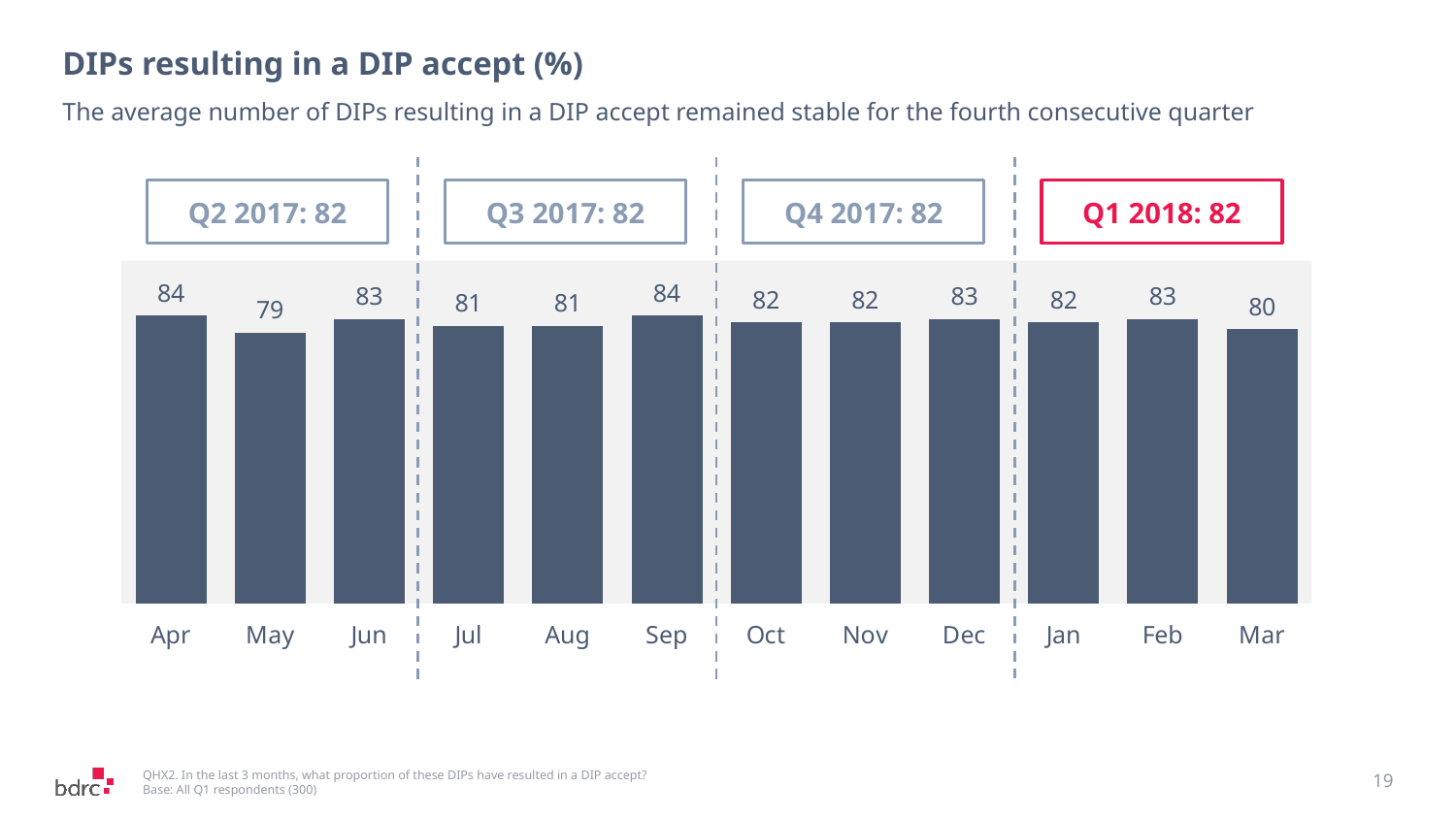
What is the value for Feb? 83 What is the difference between the values for Feb and Mar? 3 What is the title of the chart? DIPs resulting in a DIP accept (%) What is the value for Sep? 84 What kind of chart is this? bar chart What is the quarterly average shown for Q1 2018? 82 What is the value for Mar? 80 What is the difference between the values for Apr and May? 5 Which is larger, the value for Jun or the value for Jul? Jun What is the value for May? 79 How many months are shown on the x axis? 12 Which month has the lowest value? May